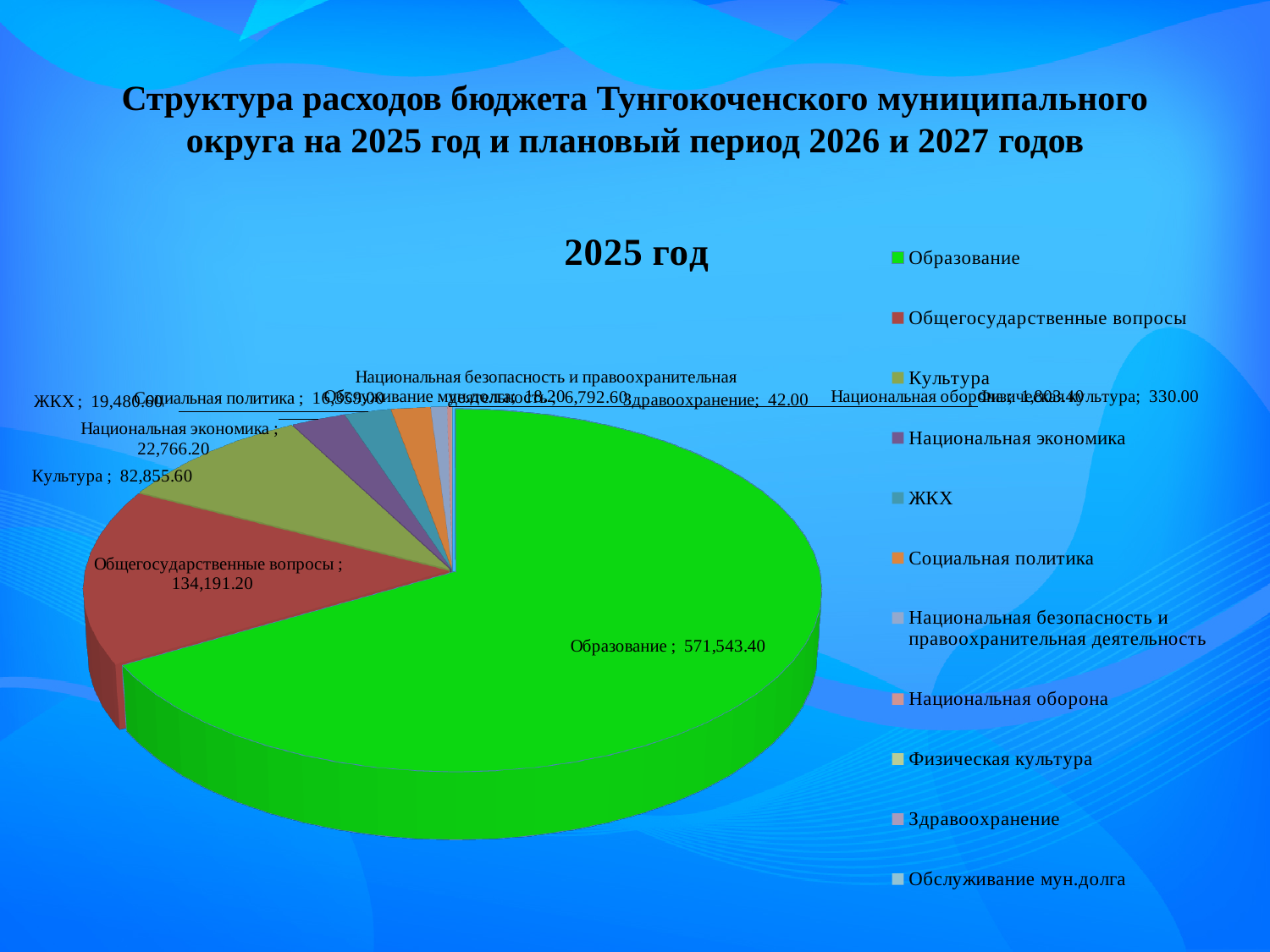
What is the value shown for Образование? 571,543.40 What is the value shown for Культура? 82,855.60 How many data series does the pie chart show? 1 What is the title shown above the pie chart? 2025 год What is the value shown for Общегосударственные вопросы? 134,191.20 Which is larger, the value for Культура or the value for Национальная экономика? Культура How many categories does the legend of the pie chart list? 11 What is the difference between the values for Образование and Общегосударственные вопросы? 437,352.20 What is the value shown for ЖКХ? 19,480.60 What kind of chart is shown on the slide? pie chart What is the value shown for Национальная экономика? 22,766.20 Which category has the largest slice in the pie chart? Образование